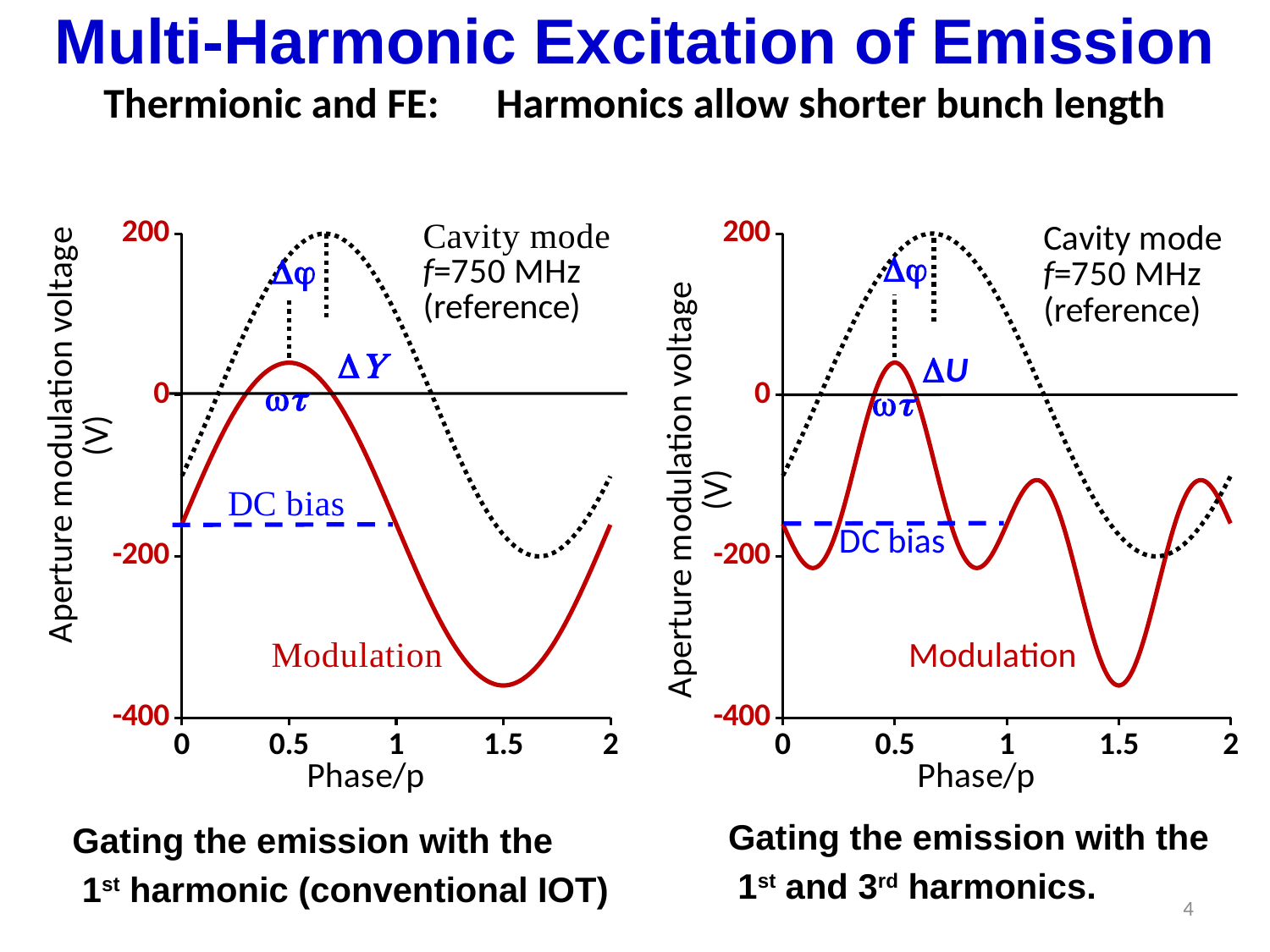
On the left chart, is the value of the Modulation curve at phase 1.5 greater or less than -200? less What kind of chart is the left chart, titled 'Gating the emission with the 1st harmonic (conventional IOT)'? Line chart On the left chart, is the DC bias level greater or less than -200? greater On the right chart, is the value of the Modulation curve at phase 0.5 greater or less than 0? greater On the left chart, at phase 1.5, which curve has the lower value: the Modulation curve or the Cavity mode curve? Modulation On the right chart, what is the label of the x axis? Phase/p On the left chart, what frequency is given for the cavity mode reference curve? f=750 MHz What is the highest tick value shown on the y axis of the right chart? 200 On the left chart, what is the label of the y axis? Aperture modulation voltage (V) On the left chart, does the Modulation curve rise or fall as the phase goes from 0.5 to 1.5? Fall